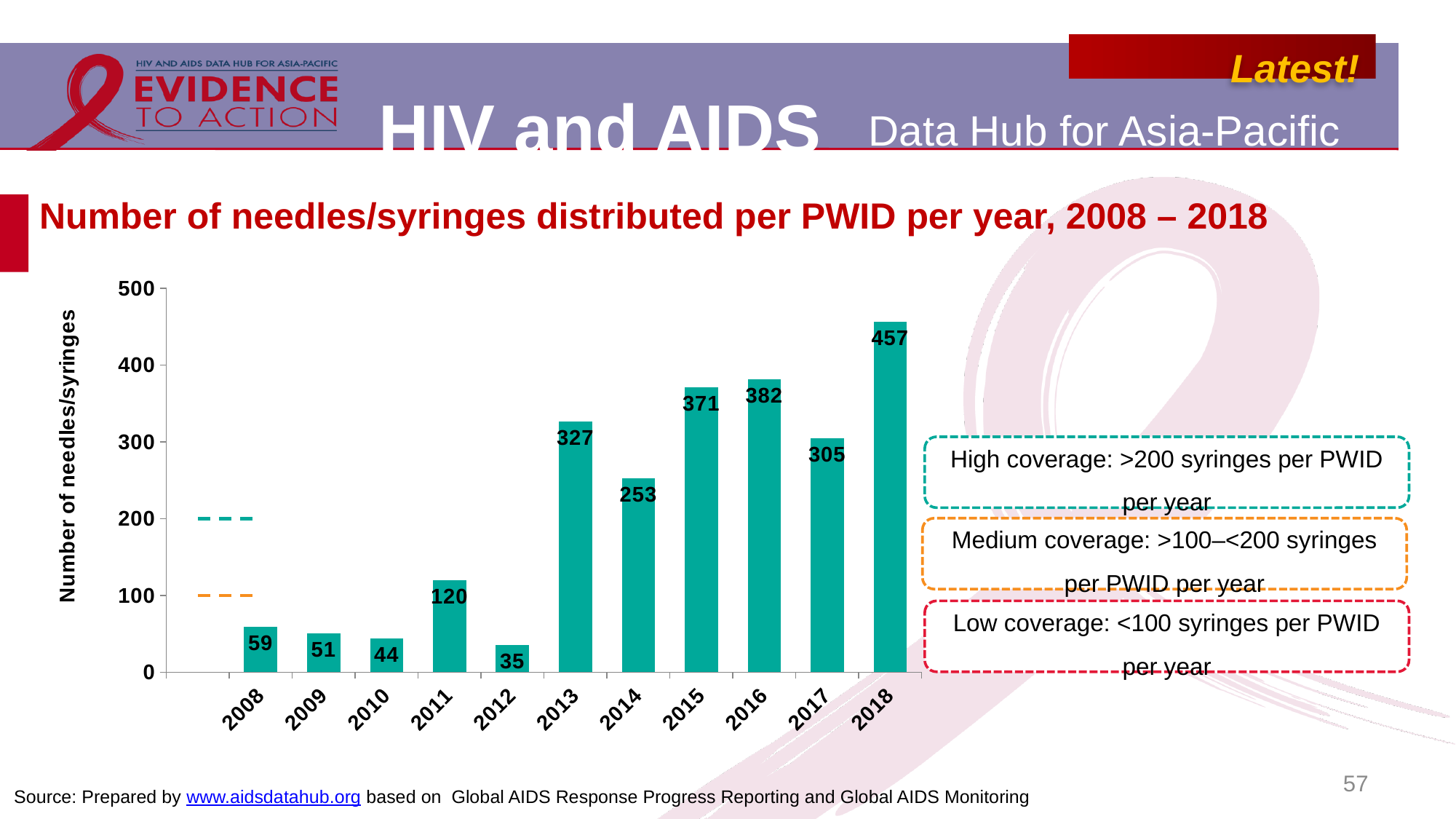
What is the value shown for 2011? 120 How many years are shown on the x axis? 11 What is the difference between the values for 2018 and 2017? 152 What is the number of needles/syringes distributed per PWID in 2018? 457 What is the difference between the values for 2016 and 2015? 11 Which year has a larger value, 2014 or 2017? 2017 What is the value shown for 2013? 327 What kind of chart is shown on the slide? Bar chart What is the label of the y axis? Number of needles/syringes Is the value for 2016 greater or less than 300? greater Which year has the lowest number of needles/syringes distributed per PWID? 2012 Which year has the highest number of needles/syringes distributed per PWID? 2018